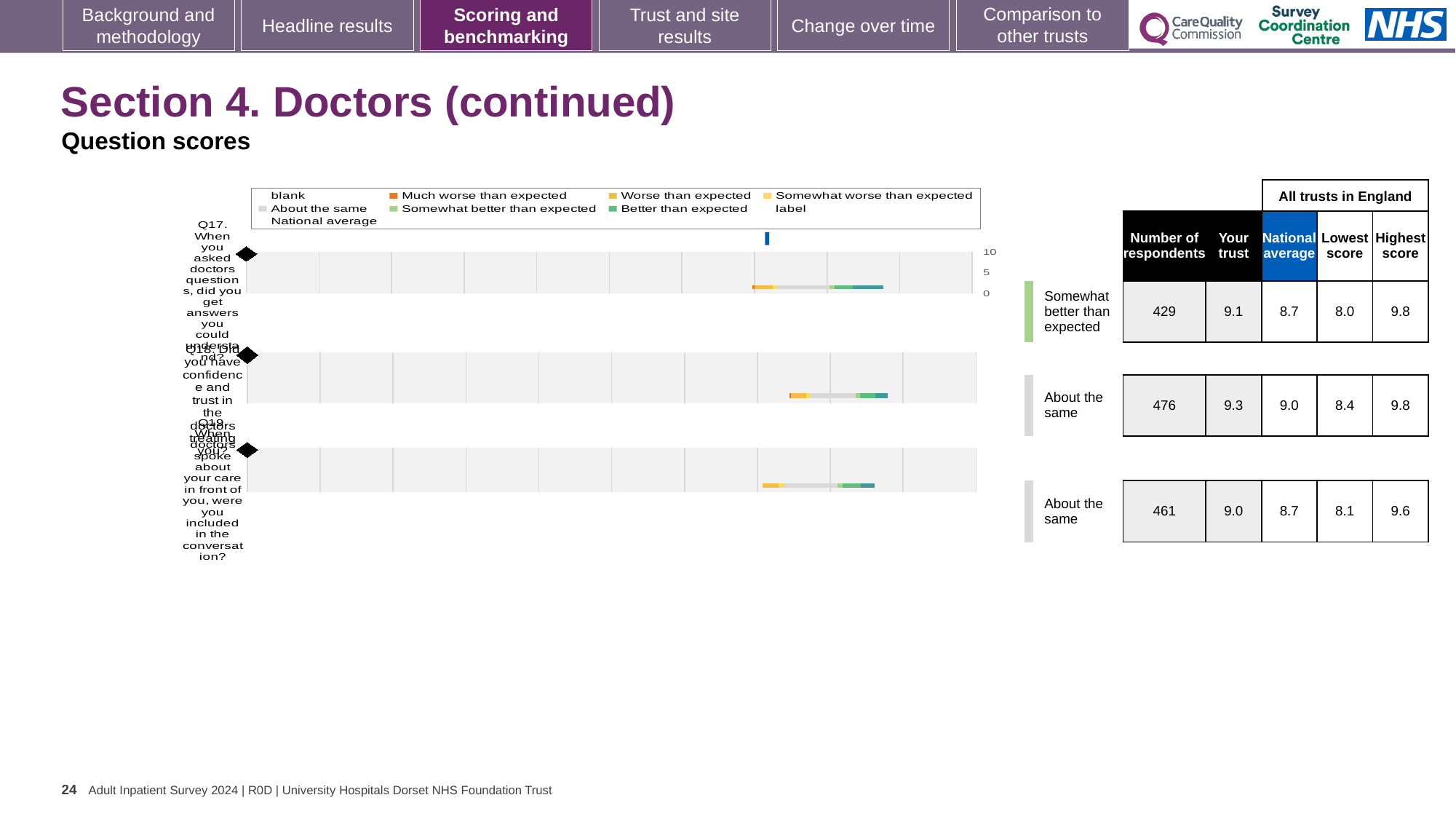
Which question has the highest 'Your trust' score? Q18 What kind of chart is used to show the question scores on this slide? bar chart What benchmark rating is shown for Q17? Somewhat better than expected For Q19, which is larger: the 'Your trust' score or the national average? Your trust What is the national average score for Q18 (Did you have confidence and trust in the doctors treating you?)? 9.0 Which question has the lowest number of respondents? Q17 For Q17, how much higher is the 'Your trust' score than the national average? 0.4 What is the highest score among all trusts in England for Q19? 9.6 What is the 'Your trust' score for Q17 (When you asked doctors questions, did you get answers you could understand?)? 9.1 How many respondents answered Q19 (When doctors spoke about your care in front of you, were you included in the conversation?)? 461 How many entries does the chart legend list? 9 How many questions (rows) are plotted in the chart? 3